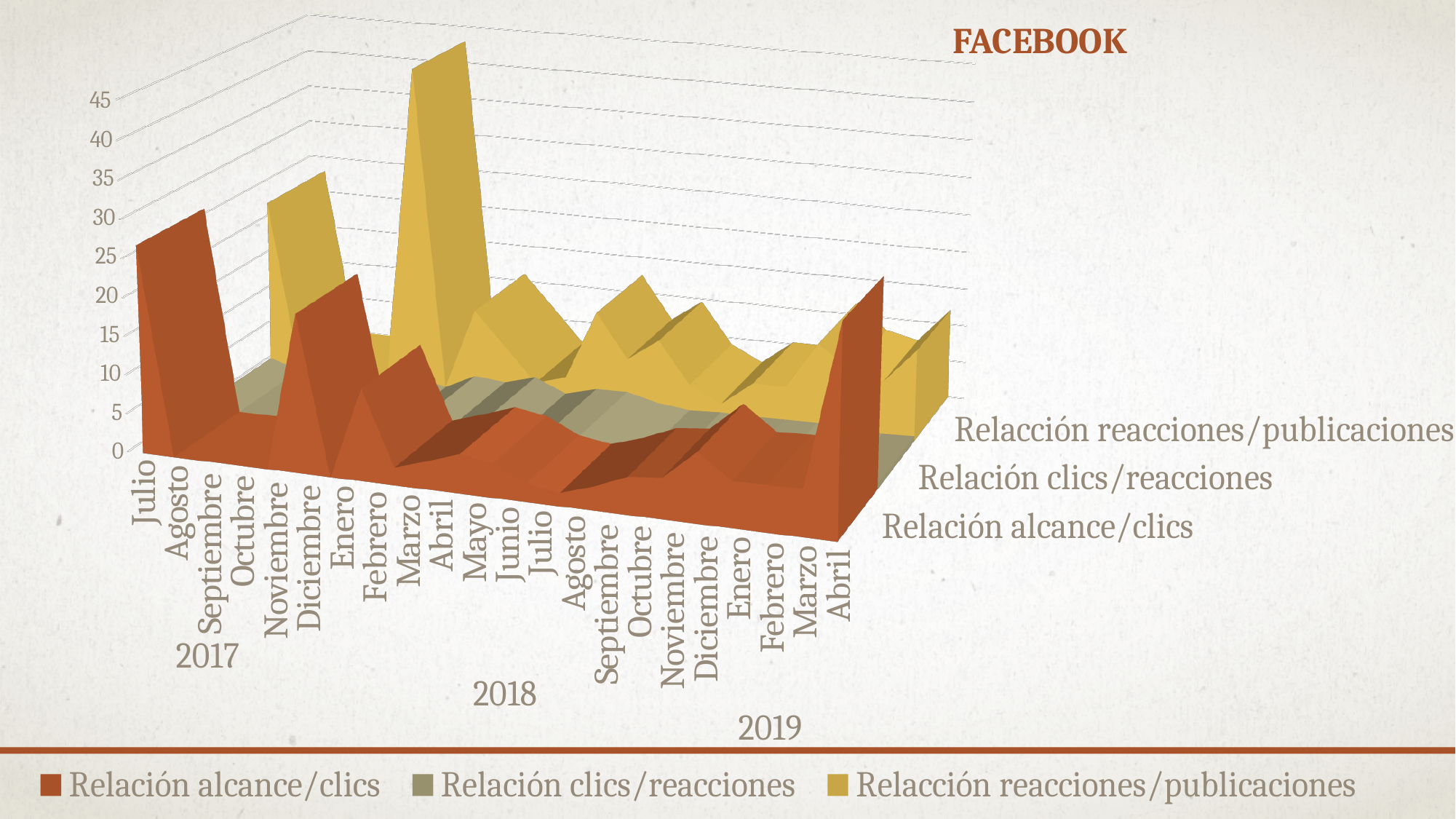
Which series is shown in yellow in the legend? Relacción reacciones/publicaciones What kind of chart is shown on the slide? Area chart Is the value of Relación alcance/clics in Julio 2017 greater or less than 20? greater How many series does the legend list? 3 Does the Relación alcance/clics series rise or fall from Marzo 2019 to Abril 2019? rise Is the value of Relación alcance/clics in Octubre 2017 greater or less than 10? less Is the value of Relacción reacciones/publicaciones in Abril 2018 greater or less than 30? less How many months (categories) are plotted along the x axis? 22 What is the title of the chart? FACEBOOK In which month does the Relacción reacciones/publicaciones series reach its highest value? Diciembre 2017